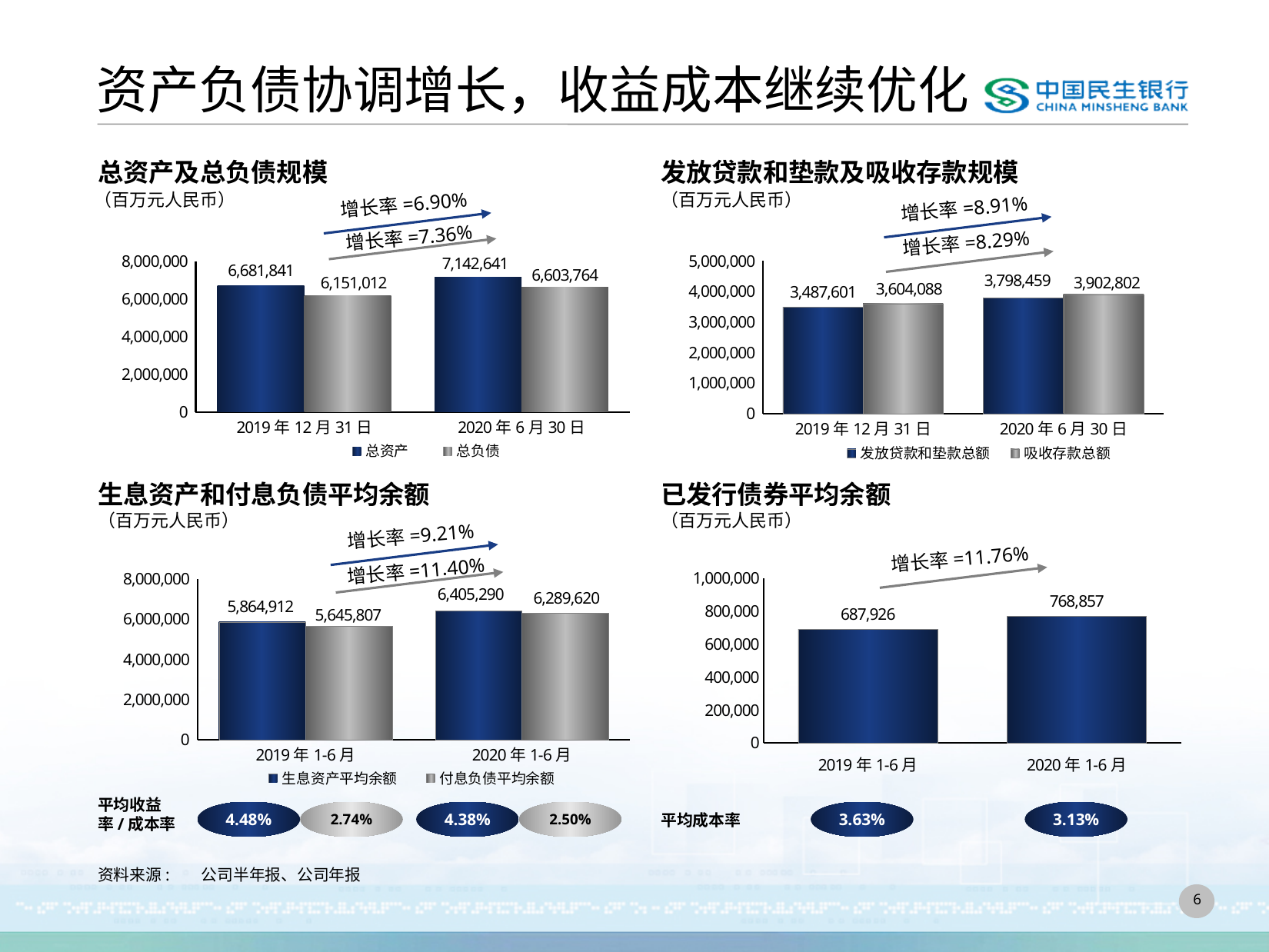
In the chart titled 已发行债券平均余额, how many categories are shown on the x axis? 2 In the chart titled 已发行债券平均余额, what is the value for 2019年1-6月? 687,926 In the chart titled 发放贷款和垫款及吸收存款规模, how many series does the legend list? 2 In the chart titled 发放贷款和垫款及吸收存款规模, which is larger for 2019年12月31日: 发放贷款和垫款总额 or 吸收存款总额? 吸收存款总额 In the chart titled 生息资产和付息负债平均余额, what is the value of 付息负债平均余额 for 2020年1-6月? 6,289,620 In the chart titled 总资产及总负债规模, what is the value of 总负债 for 2019年12月31日? 6,151,012 In the chart titled 生息资产和付息负债平均余额, which bar is the lowest? 付息负债平均余额 for 2019年1-6月 In the chart titled 已发行债券平均余额, what is the difference between the 2020年1-6月 value and the 2019年1-6月 value? 80,931 In the chart titled 总资产及总负债规模, what is the difference between 总资产 for 2020年6月30日 and 总资产 for 2019年12月31日? 460,800 In the chart titled 总资产及总负债规模, what is the value of 总资产 for 2020年6月30日? 7,142,641 In the chart titled 发放贷款和垫款及吸收存款规模, what is the value of 吸收存款总额 for 2020年6月30日? 3,902,802 What kind of chart is the chart titled 已发行债券平均余额? bar chart